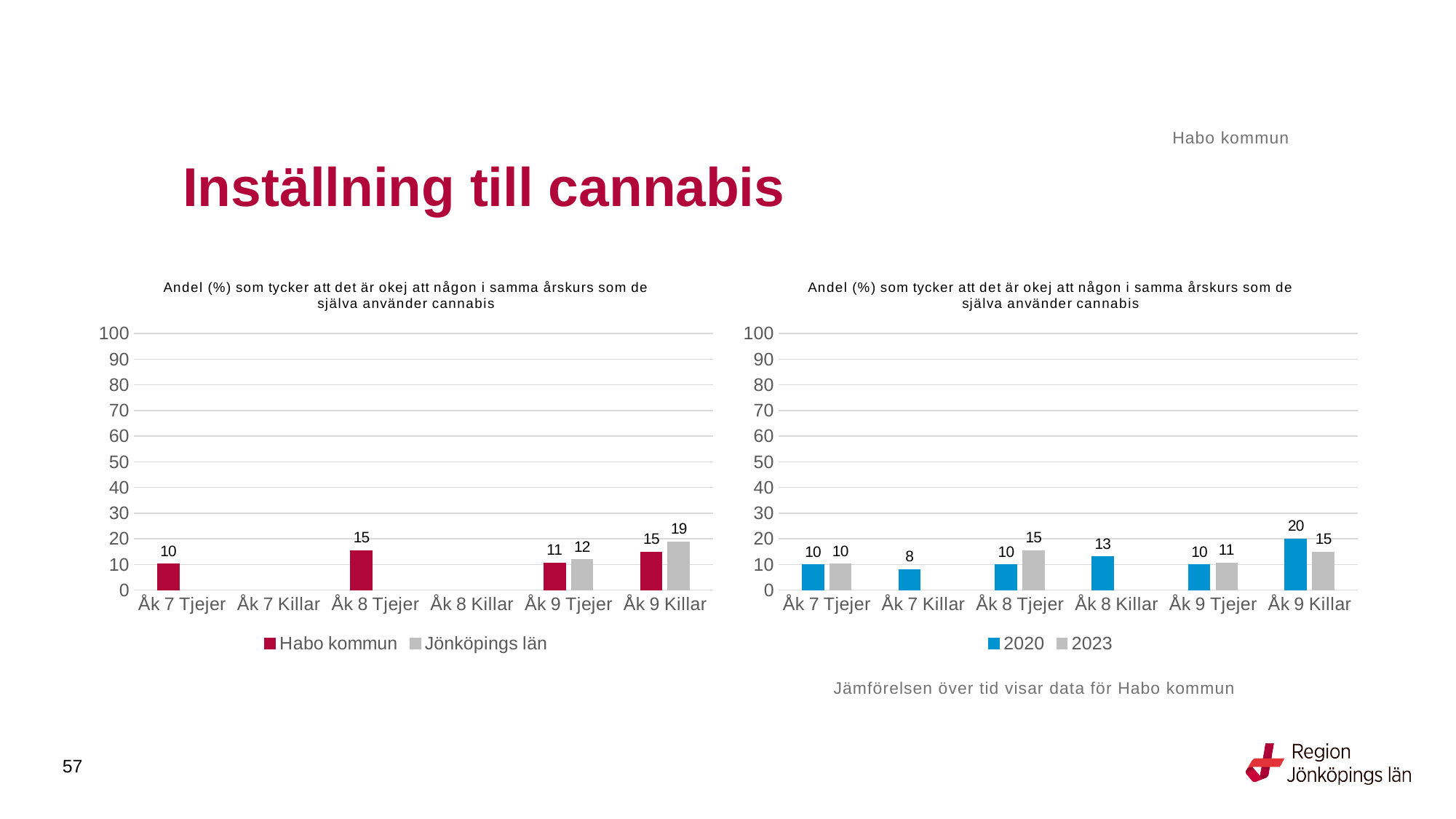
What kind of chart is the right chart? Bar chart In the right chart, what is the difference between the 2020 and 2023 values for Åk 9 Killar? 5 In the left chart, what is the value for Jönköpings län for Åk 9 Killar? 19 In the left chart, which series has the larger value for Åk 9 Tjejer, Habo kommun or Jönköpings län? Jönköpings län In the right chart, what is the 2023 value for Åk 8 Tjejer? 15 In the right chart, what is the 2020 value for Åk 9 Killar? 20 In the right chart, which category has the highest 2020 value? Åk 9 Killar In the left chart, what is the value for Habo kommun for Åk 8 Tjejer? 15 In the right chart, which category has the lowest 2020 value? Åk 7 Killar In the left chart, what is the difference between Jönköpings län and Habo kommun for Åk 9 Killar? 4 In the right chart, how many categories are shown on the x axis? 6 In the left chart, how many series does the legend list? 2